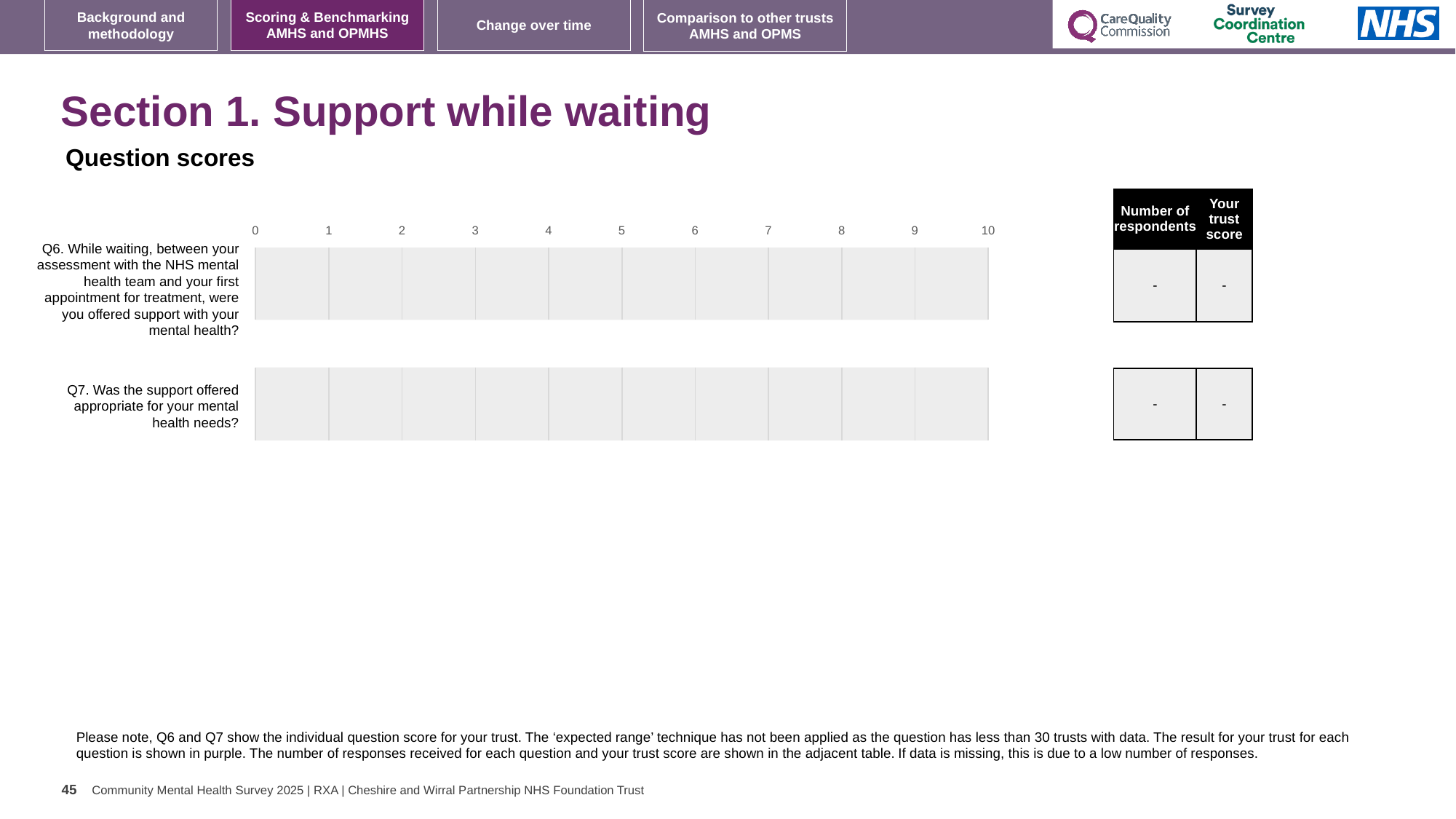
What is shown in the 'Number of respondents' column for Q7? - What is the maximum value shown on the chart's x axis? 10 What is the minimum value shown on the chart's x axis? 0 What is shown in the 'Number of respondents' column for Q6? - What kind of chart is shown on the slide? bar chart What is shown in the 'Your trust score' column for Q6? - What is shown in the 'Your trust score' column for Q7? - How many questions (categories) are listed on the chart? 2